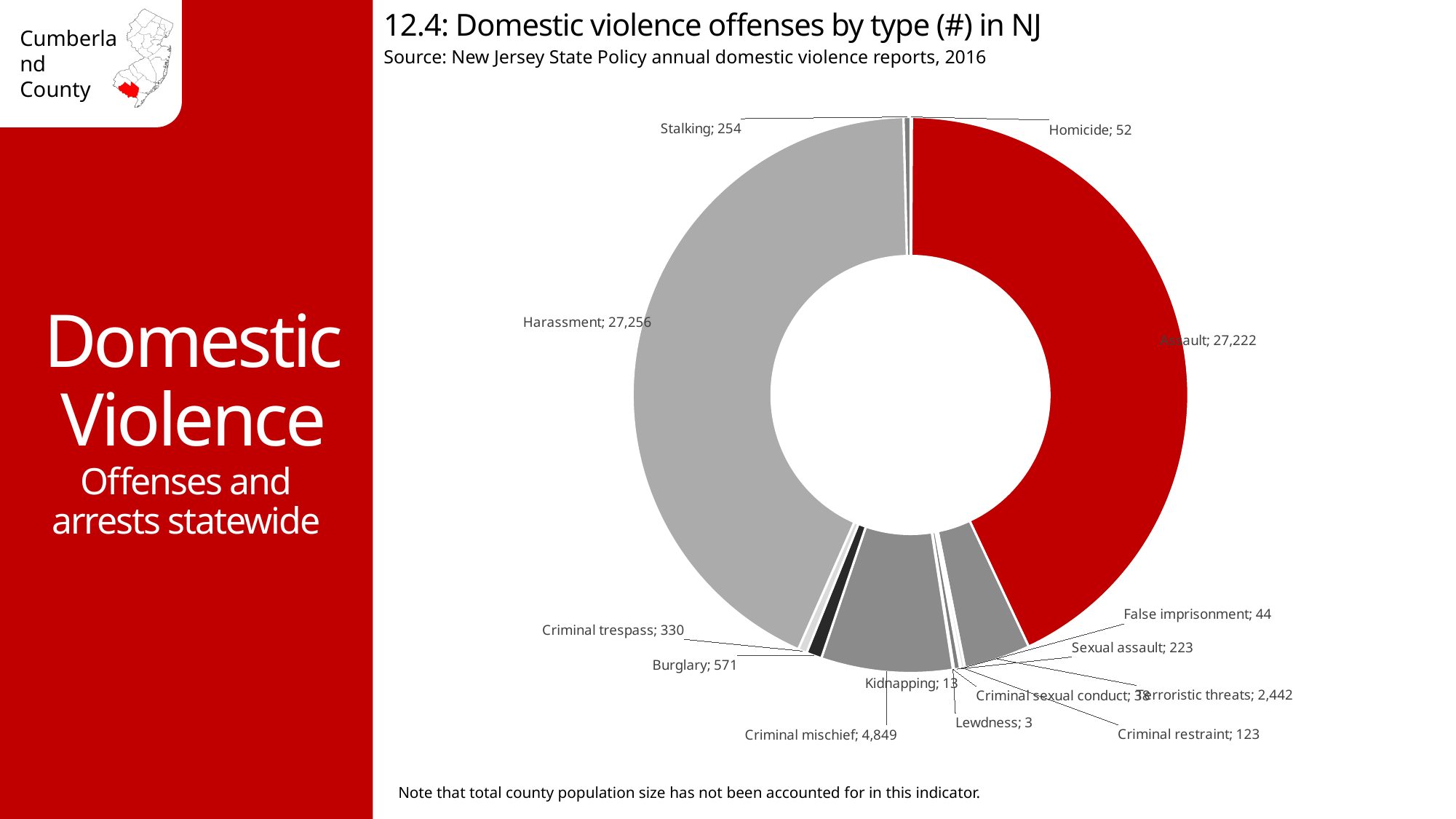
Which offense type has the largest value on the chart? Harassment How many Harassment offenses does the chart show? 27,256 Which is larger, Stalking or Sexual assault? Stalking What is the difference between the Burglary and Criminal trespass values? 241 What is the value for Criminal mischief? 4,849 How many Homicide offenses are shown? 52 Which offense type has the smallest value on the chart? Lewdness What is the value for Terroristic threats? 2,442 What is the number of Assault offenses shown on the chart? 27,222 What is the difference between the Criminal mischief and Terroristic threats values? 2,407 What kind of chart is shown on the slide? doughnut chart What colour is the Assault segment of the chart? red